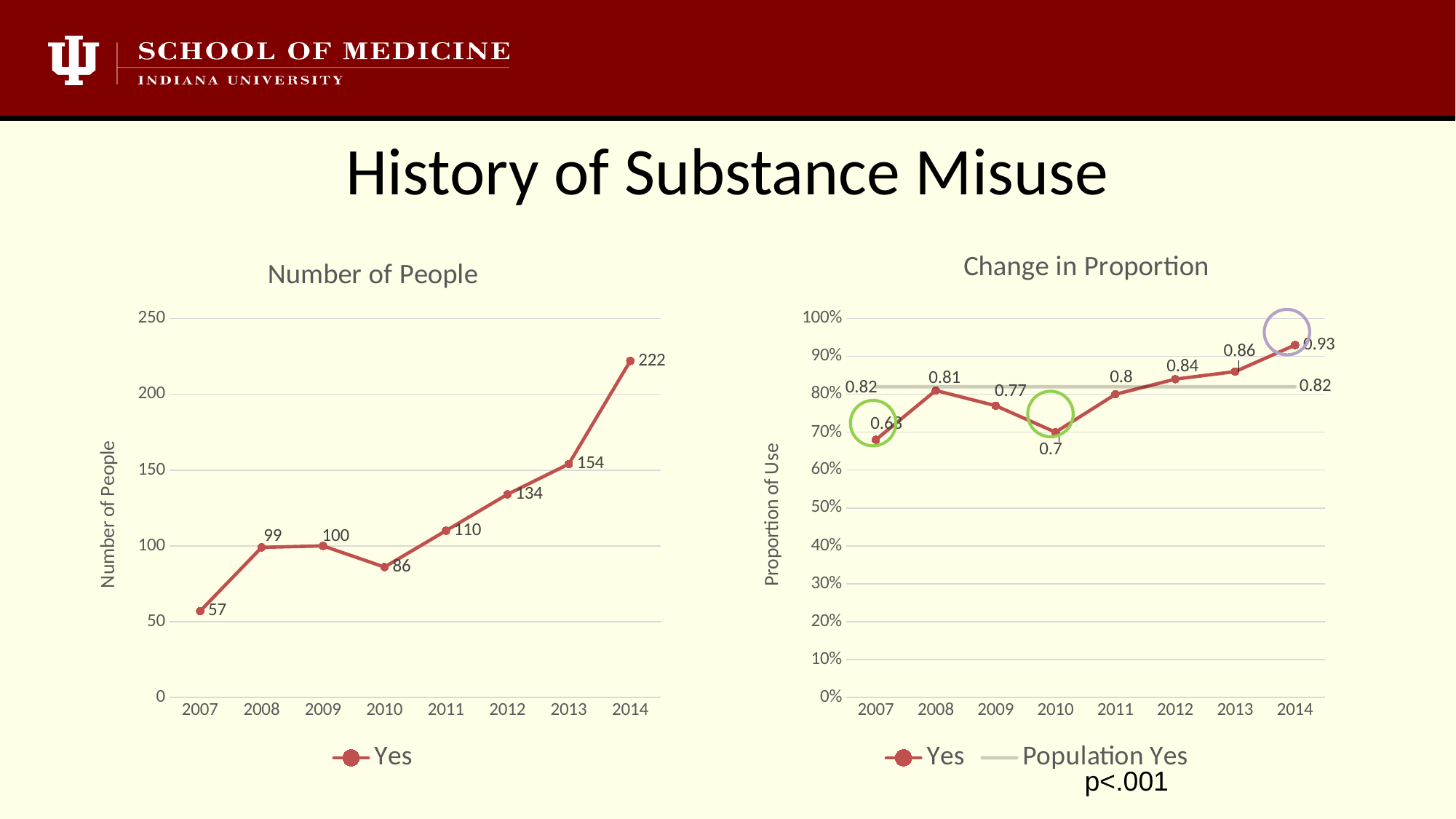
What kind of chart is the Number of People chart? line chart In the Change in Proportion chart, which year has the highest Yes value? 2014 In the Change in Proportion chart, what is the value of the Population Yes line? 0.82 In the Number of People chart, which year has the lowest value? 2007 In the Number of People chart, what is the difference between the values for 2014 and 2013? 68 In the Change in Proportion chart, what is the Yes value for 2014? 0.93 In the Number of People chart, how many years are plotted on the x axis? 8 In the Change in Proportion chart, what is the Yes value for 2010? 0.7 In the Number of People chart, what is the value for 2014? 222 In the Change in Proportion chart, how many series does the legend list? 2 In the Number of People chart, what is the value for 2010? 86 In the Change in Proportion chart, is the Yes value for 2012 larger or smaller than the Yes value for 2009? larger